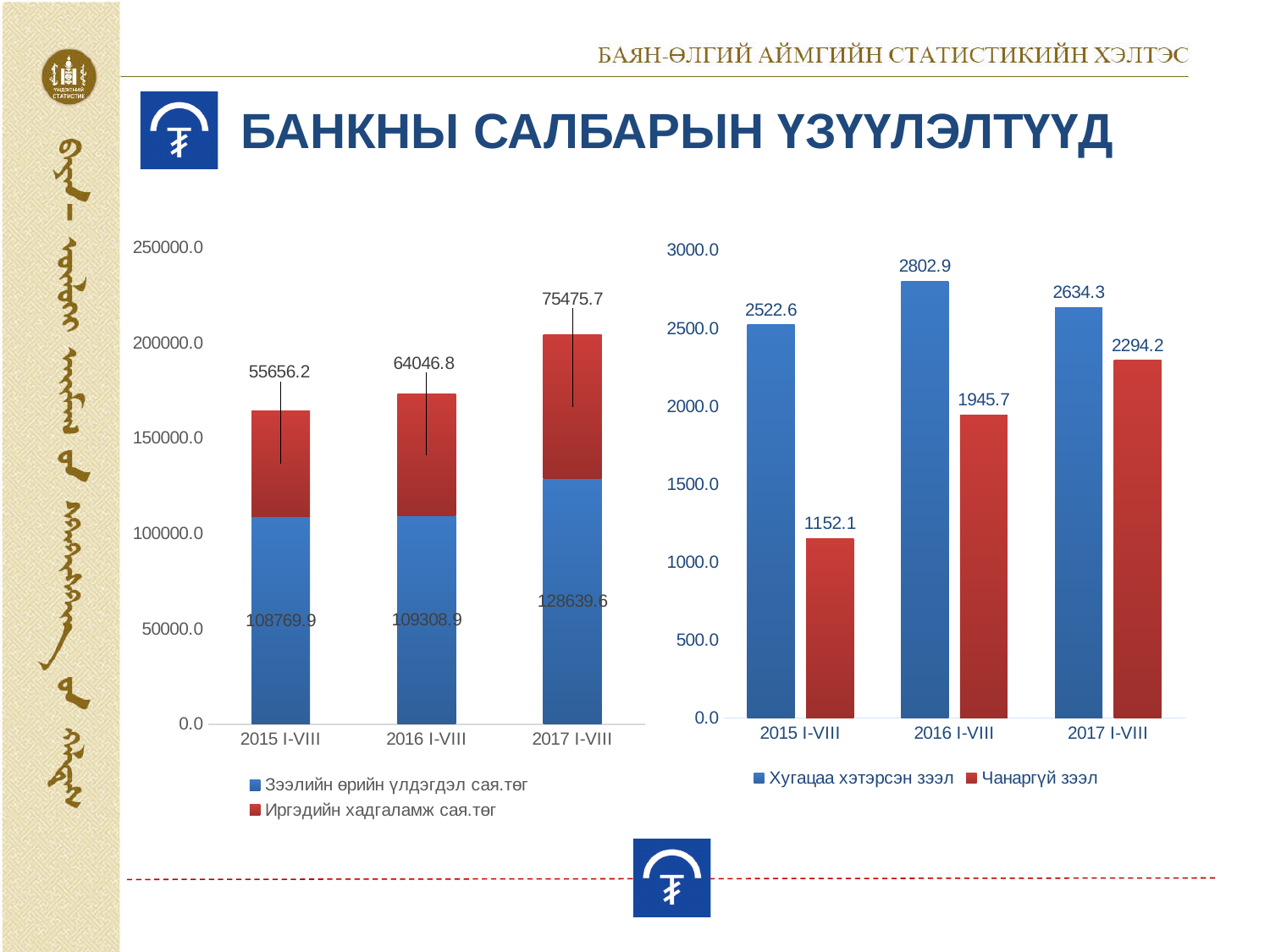
In the right chart, which period has the highest value for Хугацаа хэтэрсэн зээл? 2016 I-VIII In the right chart, what is the value of Чанаргүй зээл for 2016 I-VIII? 1945.7 In the left chart, what is the value of Зээлийн өрийн үлдэгдэл сая.төг for 2017 I-VIII? 128639.6 In the left chart, what is the value of Иргэдийн хадгаламж сая.төг for 2015 I-VIII? 55656.2 In the left chart, which is larger for 2016 I-VIII: Зээлийн өрийн үлдэгдэл сая.төг or Иргэдийн хадгаламж сая.төг? Зээлийн өрийн үлдэгдэл сая.төг How many periods are shown on the x axis of the left chart? 3 In the left chart, what is the total of the stacked bar for 2017 I-VIII? 204115.3 In the right chart, which period has the lowest value for Чанаргүй зээл? 2015 I-VIII How many series does the legend of the right chart list? 2 In the right chart, does the value of Чанаргүй зээл rise or fall from 2015 I-VIII to 2017 I-VIII? rise What type of chart is the left chart? stacked bar chart In the right chart, what is the difference between Хугацаа хэтэрсэн зээл and Чанаргүй зээл for 2016 I-VIII? 857.2